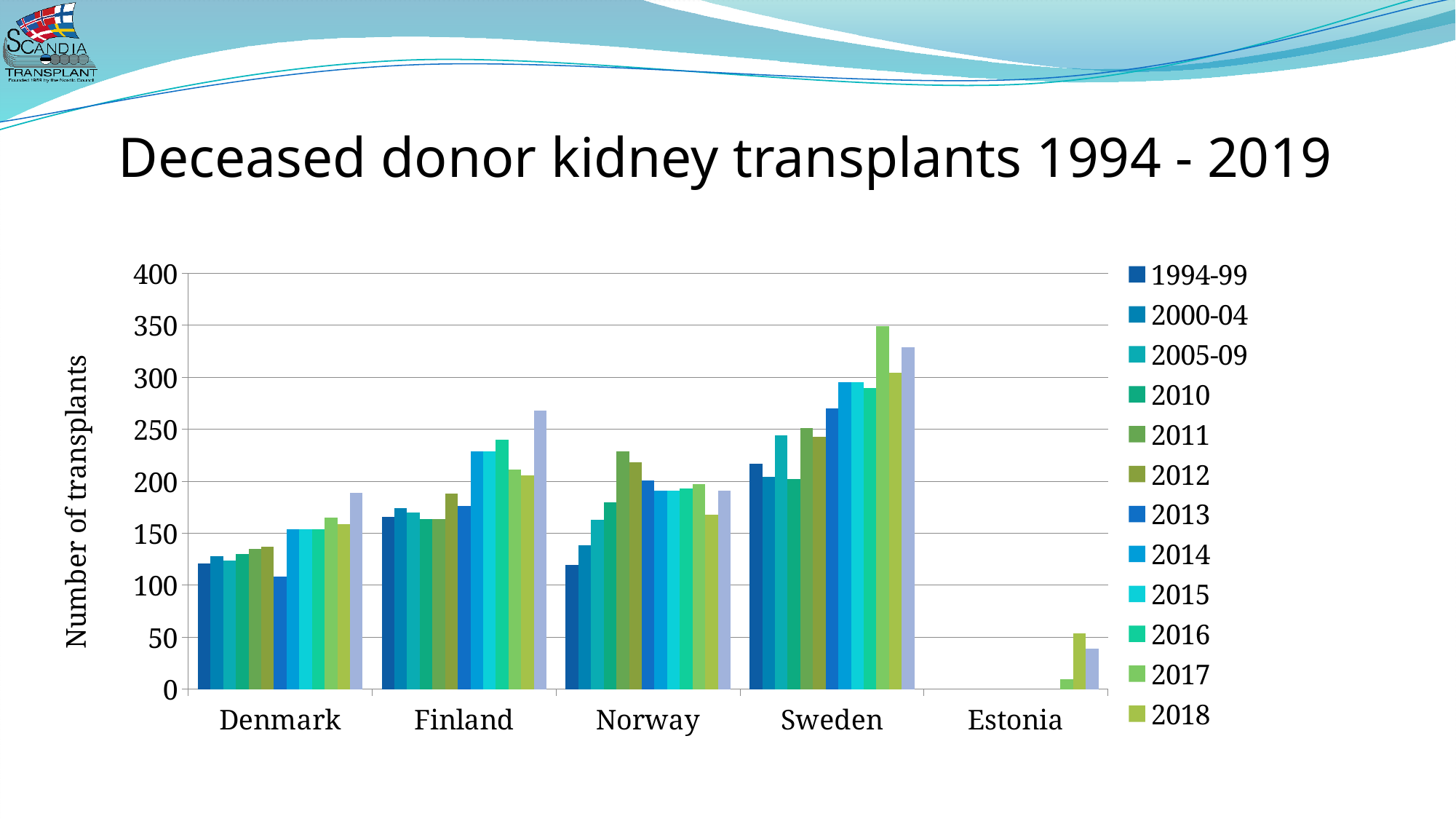
What is the title of the slide? Deceased donor kidney transplants 1994 - 2019 Is the value for Sweden in 2017 greater or less than 300? greater Is the value for Norway in 1994-99 greater or less than 150? less Is the value for Finland in 2016 greater or less than 200? greater Do Sweden's values generally rise or fall from 1994-99 to 2017? rise What kind of chart is shown on the slide? bar chart Which country has the highest number of deceased donor kidney transplants? Sweden Which is larger, the 2017 value for Sweden or the 2017 value for Finland? Sweden Which country has the lowest number of deceased donor kidney transplants? Estonia What is the label of the vertical axis? Number of transplants How many countries are shown on the x axis? 5 How many entries does the legend list? 12